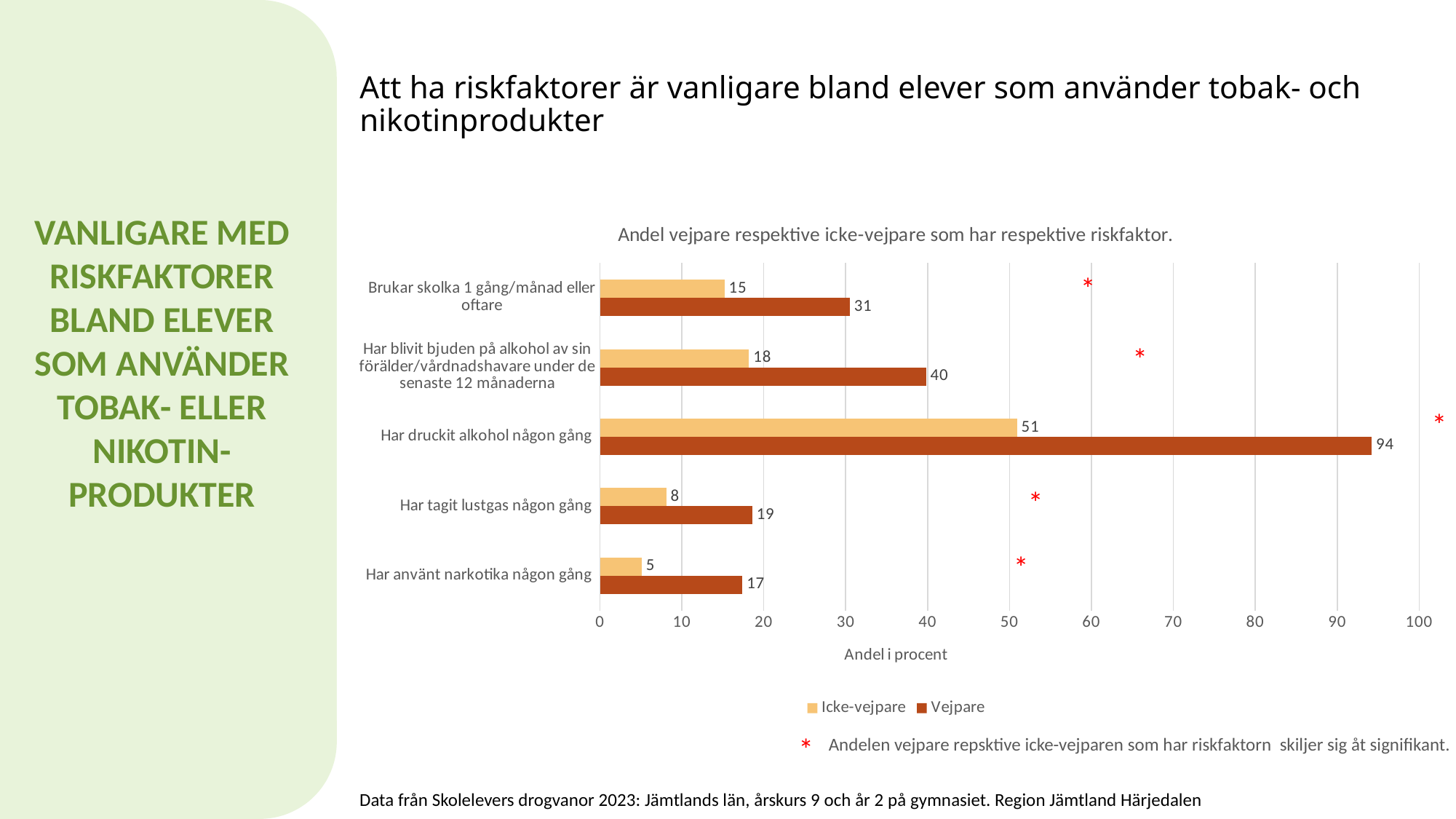
What is the value for Vejpare in the category 'Har druckit alkohol någon gång'? 94 Which category has the highest value for Icke-vejpare? Har druckit alkohol någon gång What is the title of the chart? Andel vejpare respektive icke-vejpare som har respektive riskfaktor. Which category has the lowest value for Vejpare? Har använt narkotika någon gång How many series does the legend list? 2 What is the value for Vejpare in the category 'Har tagit lustgas någon gång'? 19 What is the label of the horizontal axis? Andel i procent Which is larger: the Vejpare value for 'Har använt narkotika någon gång' or the Icke-vejpare value for 'Har blivit bjuden på alkohol av sin förälder/vårdnadshavare under de senaste 12 månaderna'? Icke-vejpare value for 'Har blivit bjuden på alkohol...' (18) What is the difference between the Vejpare and Icke-vejpare values for 'Har blivit bjuden på alkohol av sin förälder/vårdnadshavare under de senaste 12 månaderna'? 22 How many categories are shown on the chart? 5 What is the value for Icke-vejpare in the category 'Brukar skolka 1 gång/månad eller oftare'? 15 What kind of chart is shown on the slide? Bar chart